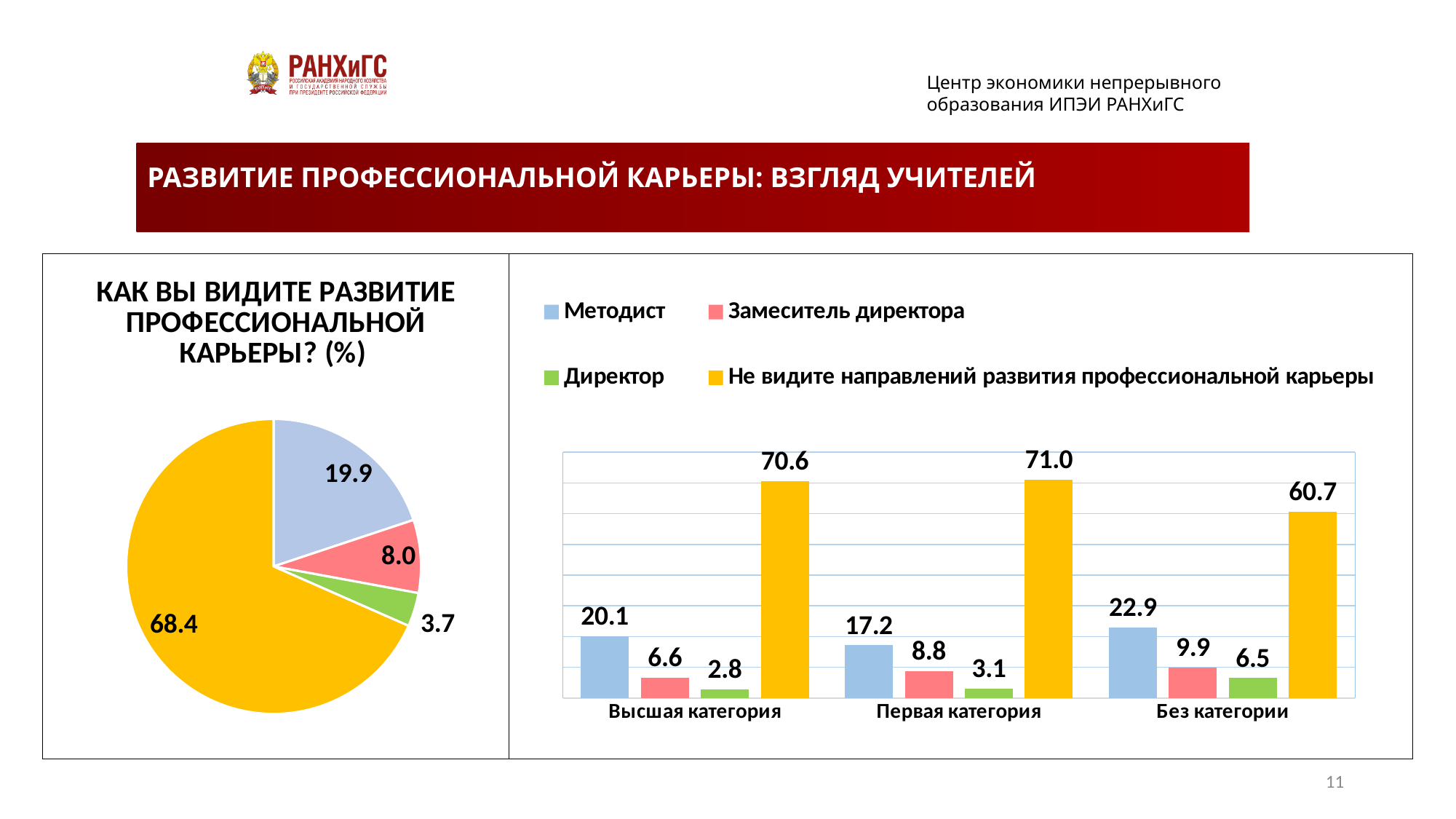
In the bar chart on the right, what is the value for Методист in the Без категории group? 22.9 In the bar chart on the right, which is larger: Заместитель директора for Первая категория or for Без категории? Без категории In the bar chart on the right, how many categories are shown on the x axis? 3 In the pie chart on the left, what is the value of the blue slice (Методист)? 19.9 How many slices does the pie chart on the left have? 4 In the bar chart on the right, what is the difference between the Методист values for Без категории and Первая категория? 5.7 In the bar chart on the right, which category has the highest value for Не видите направлений развития профессиональной карьеры? Первая категория In the pie chart on the left, what is the value of the smallest slice? 3.7 In the bar chart on the right, what is the value for Директор in the Высшая категория group? 2.8 How many series does the legend on the right list? 4 What kind of chart is shown on the right side of the slide? Bar chart In the pie chart on the left, what is the value of the largest slice? 68.4